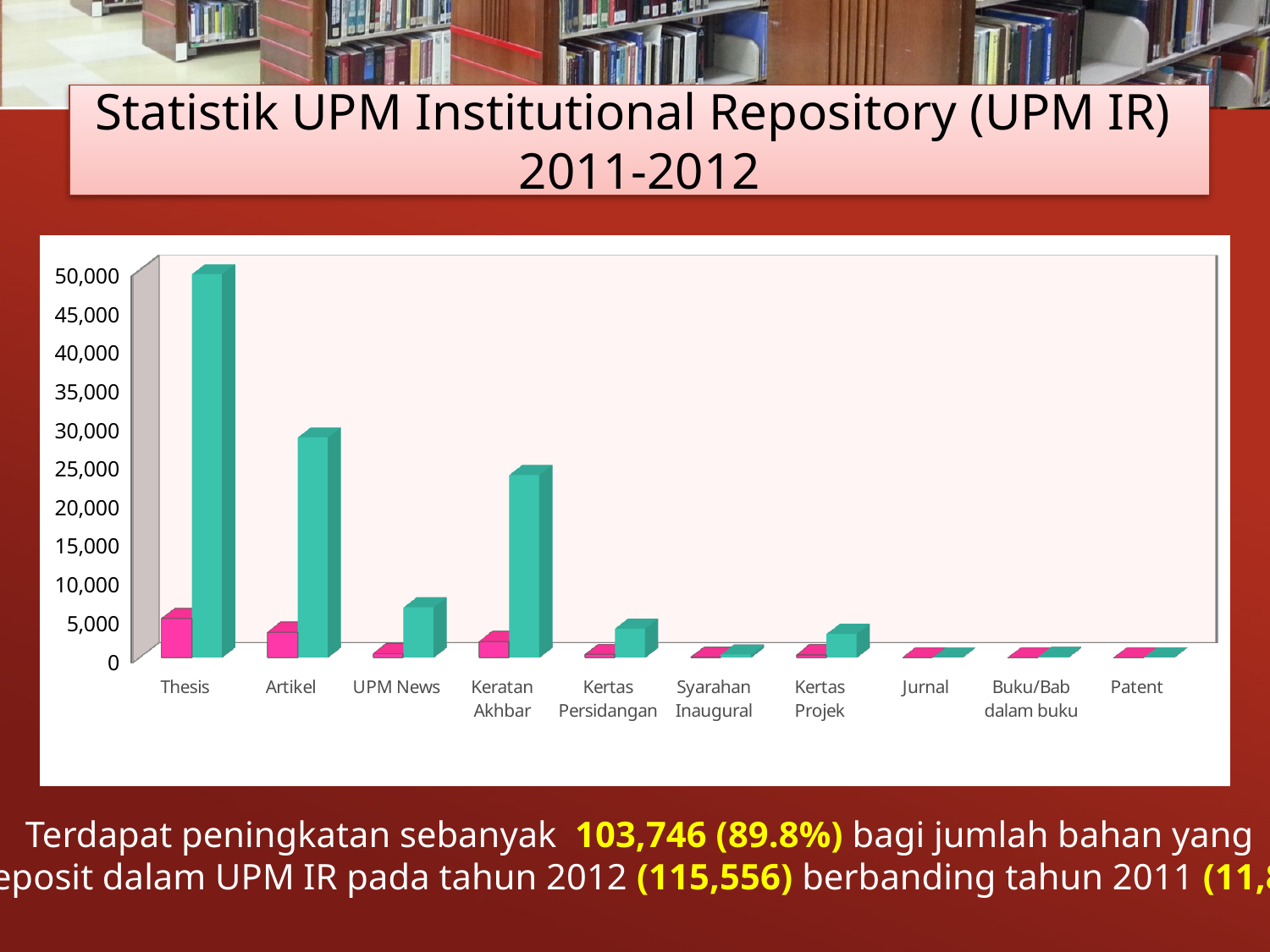
What is the title shown above the chart on the slide? Statistik UPM Institutional Repository (UPM IR) 2011-2012 What kind of chart is shown on the slide? bar chart Is the value of the taller (teal) bar for Keratan Akhbar greater or less than 20,000? greater Which has the taller teal bar, Thesis or Artikel? Thesis Which has the taller teal bar, Artikel or Keratan Akhbar? Artikel Is the value of the taller (teal) bar for Kertas Projek greater or less than 5,000? less Is the value of the taller (teal) bar for Artikel greater or less than 25,000? greater Which category has the tallest bar in the chart? Thesis How many categories are shown along the x axis of the chart? 10